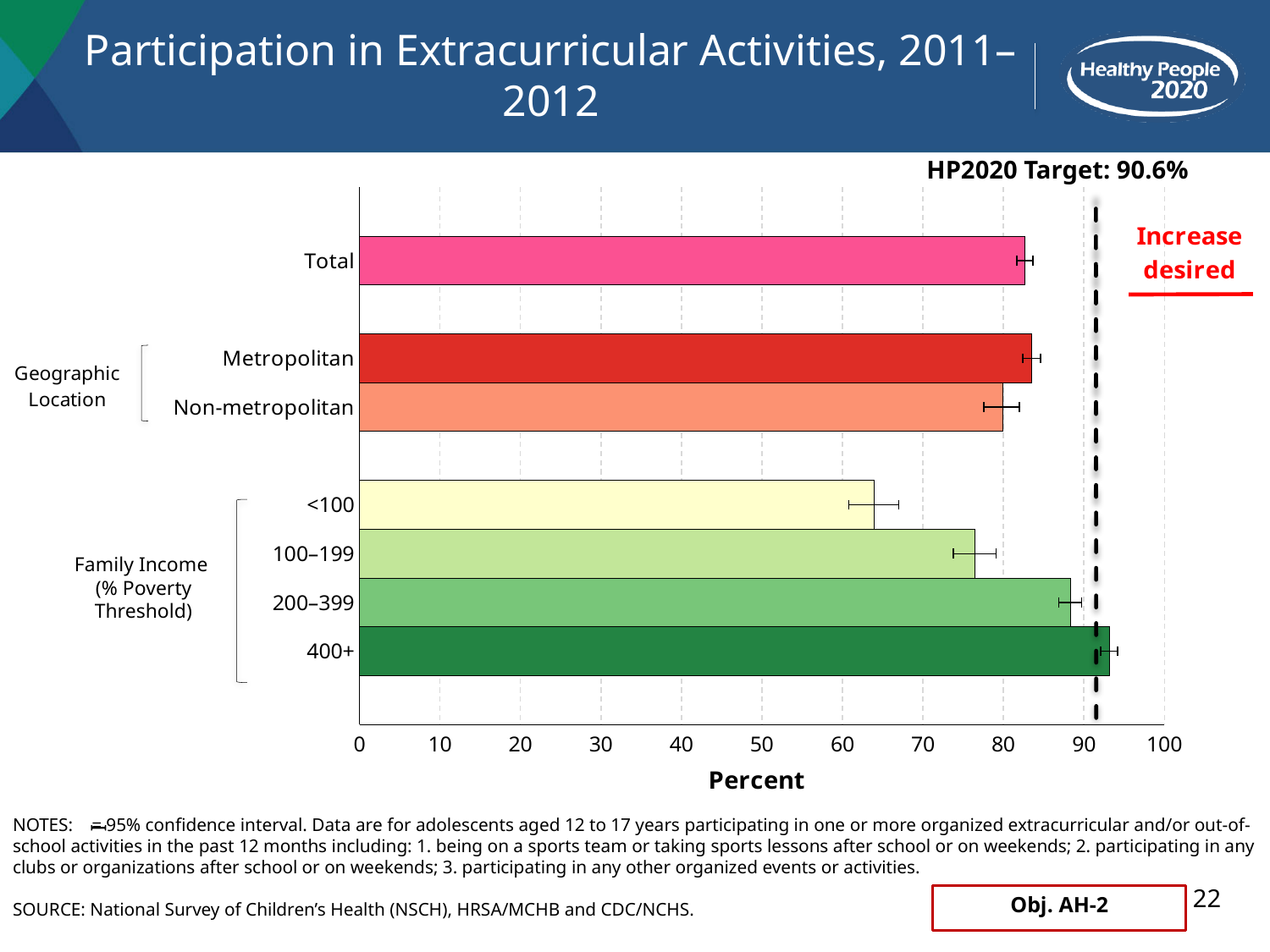
Is the value for the 400+ family income group greater or less than 90? greater Which category has the highest participation percentage? 400+ Which has a higher participation percentage, the 200–399 group or the 400+ group? 400+ Is the value for the <100 family income group greater or less than 70? less Which category has the lowest participation percentage? <100 Is the value for the 200–399 family income group greater or less than 80? greater What kind of chart is shown on the slide? bar chart What is the label of the horizontal axis? Percent What is the HP2020 Target shown on the slide? 90.6% Which has a higher participation percentage, the <100 group or the 100–199 group? 100–199 How many bars are plotted in the chart? 7